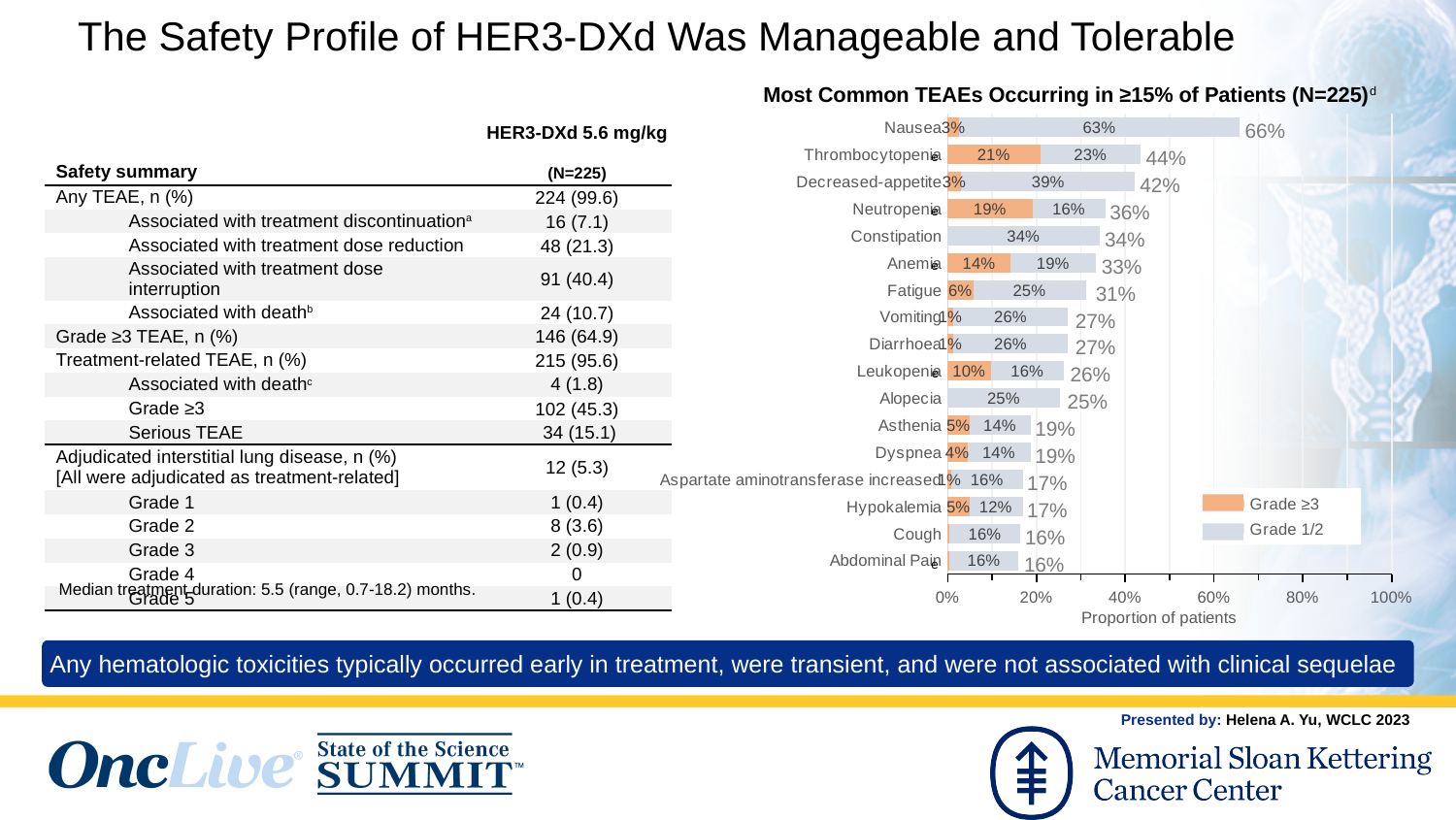
What is the x-axis label of the chart? Proportion of patients What is the total proportion of patients shown for Neutropenia in the chart? 36% How many adverse event categories are plotted in the chart? 17 What is the Grade 1/2 value for Nausea in the chart? 63% Is the total value for Decreased-appetite greater or less than 40%? greater Which adverse event has the highest total proportion of patients in the chart? Nausea Which adverse event has the highest Grade ≥3 value in the chart? Thrombocytopenia What is the Grade ≥3 value for Thrombocytopenia in the chart? 21% Which has a larger total proportion of patients in the chart, Anemia or Fatigue? Anemia What kind of chart is shown on the slide? bar chart What is the difference between the total for Nausea and the total for Thrombocytopenia in the chart? 22% How many series does the chart legend list? 2